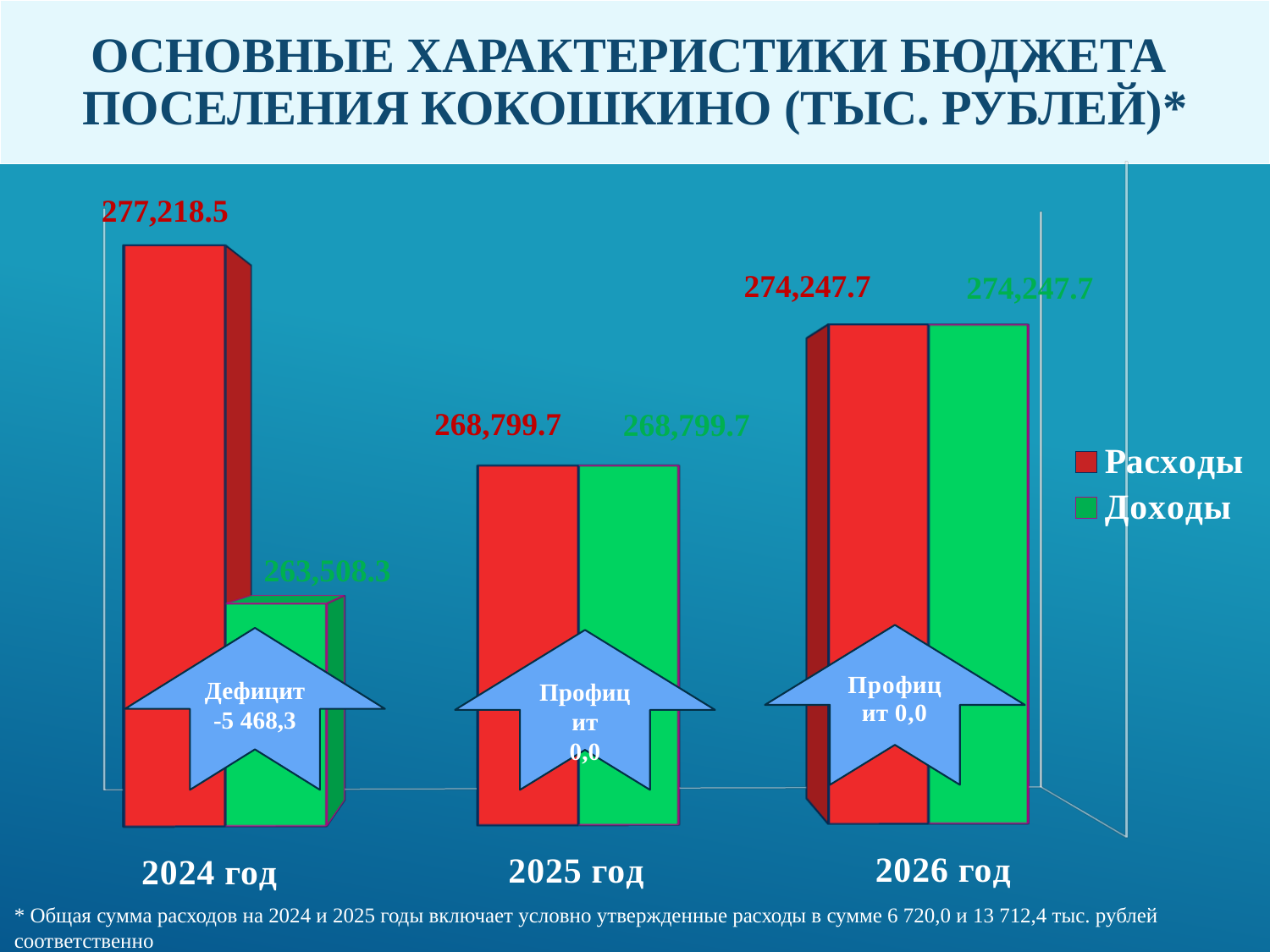
What is the difference between Расходы and Доходы in 2024 год? 13,710.2 In 2024 год, which is larger: Расходы or Доходы? Расходы What is the value of Доходы for 2026 год? 274,247.7 What is the value of Доходы for 2024 год? 263,508.3 Which year has the lowest value of Доходы? 2024 год How many series does the legend list? 2 What is the value of Расходы for 2024 год? 277,218.5 What is the value of Расходы for 2025 год? 268,799.7 Which year has the highest value of Расходы? 2024 год Which colour represents Доходы in the legend? Green How many years (categories) are shown on the chart? 3 What kind of chart is shown on the slide? Bar chart